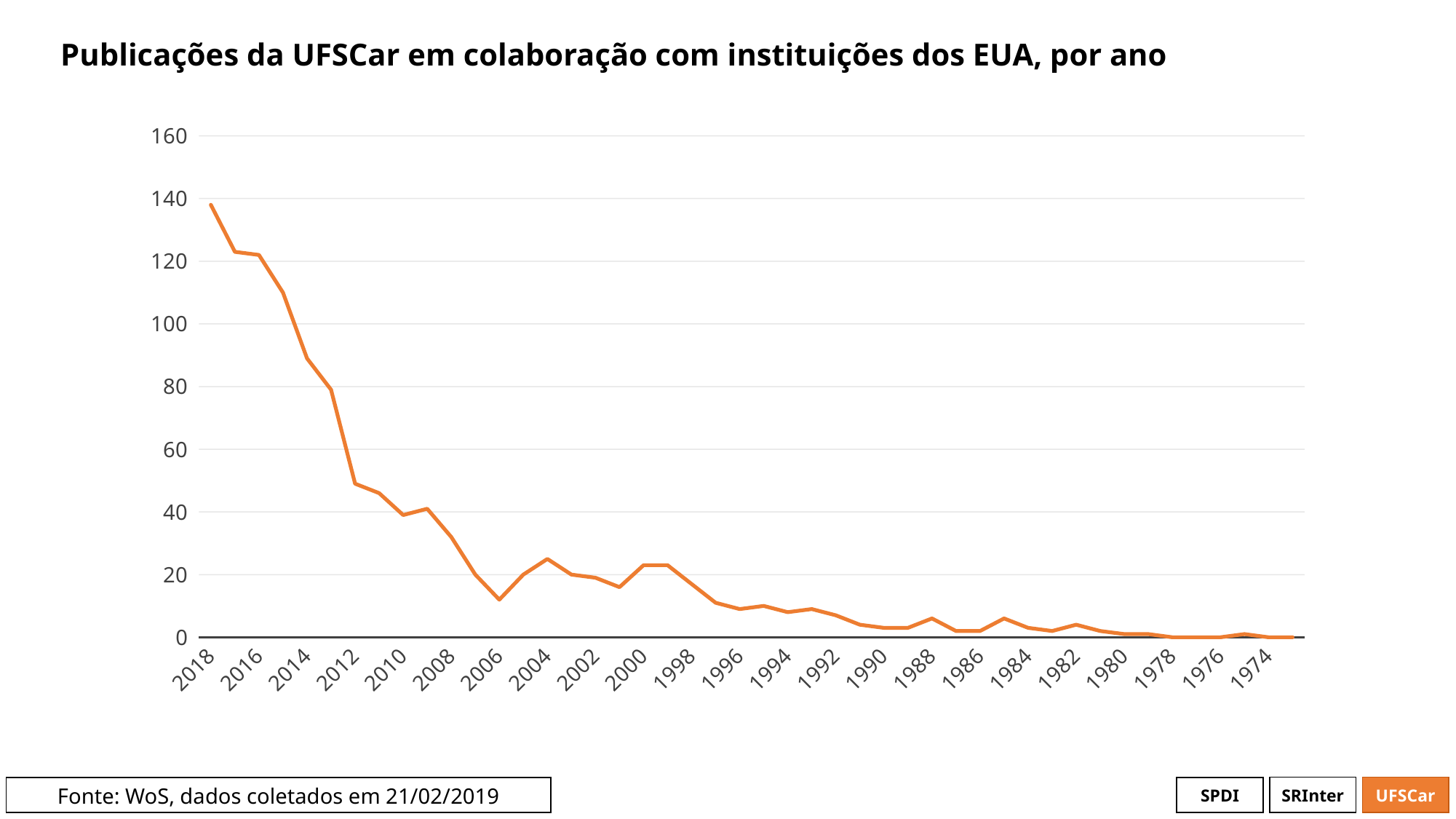
Is the value for 2014 greater or less than 100? less Which year has more publications, 2004 or 2006? 2004 Is the value for 2012 greater or less than 60? less Is the value for 2006 greater or less than 20? less What is the title of the chart? Publicações da UFSCar em colaboração com instituições dos EUA, por ano Which year has the highest number of publications? 2018 What kind of chart is shown on the slide? line chart Which year has more publications, 2018 or 2012? 2018 Moving from left (2018) to right (1974) along the x axis, do the values generally rise or fall? fall